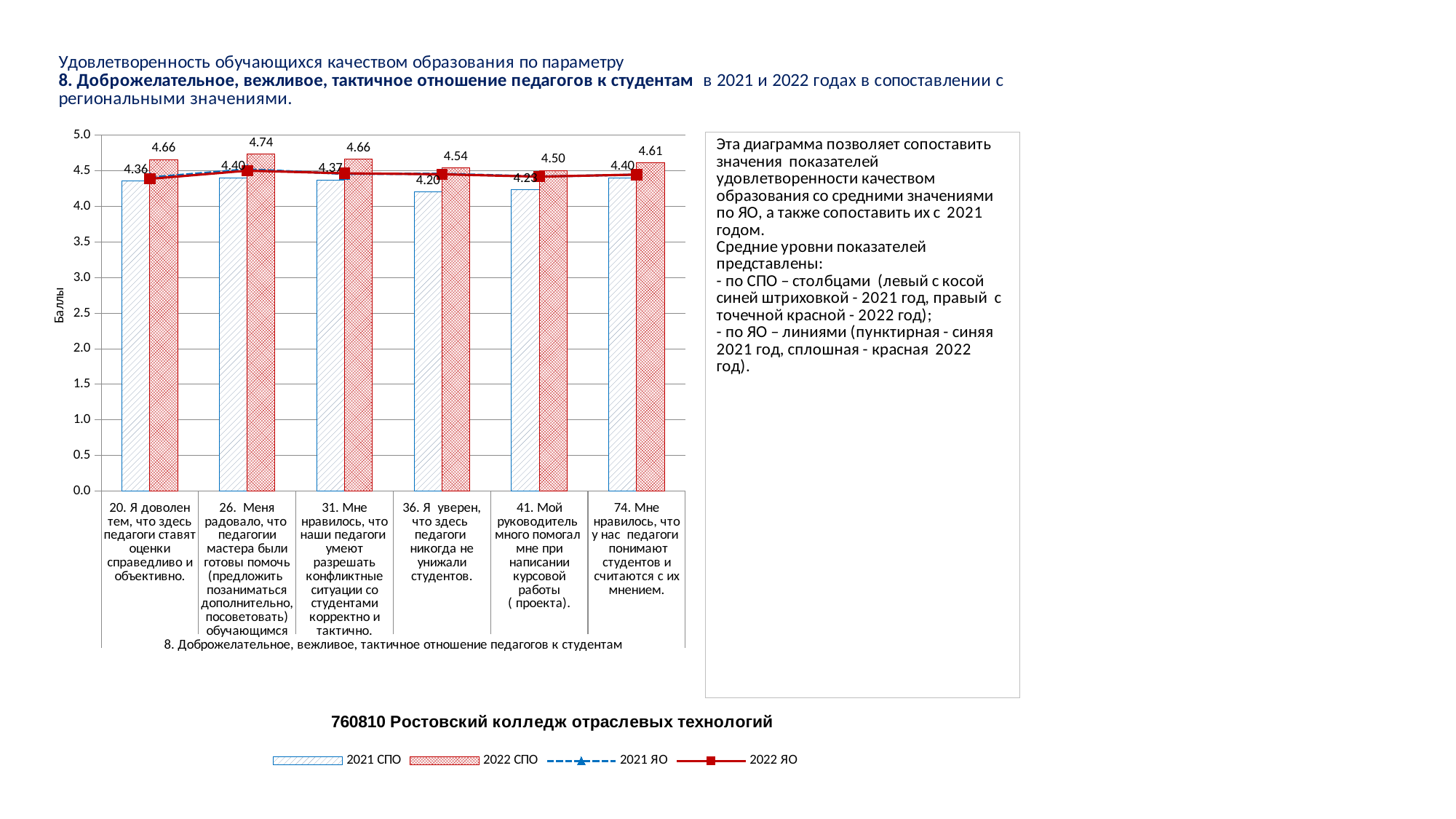
What kind of chart is shown on the slide? Combined bar and line chart Is the 2021 СПО value for category "31. Мне нравилось, что наши педагоги умеют разрешать конфликтные ситуации..." greater or less than 4.5? less Which is larger for category "74. Мне нравилось, что у нас педагоги понимают студентов и считаются с их мнением.": the 2021 СПО value or the 2022 СПО value? 2022 СПО What is the 2021 СПО value for category "41. Мой руководитель много помогал мне при написании курсовой работы (проекта)."? 4.23 How many series does the chart legend list? 4 Which category has the highest 2022 СПО value? 26. Меня радовало, что педагоги мастера были готовы помочь (предложить позаниматься дополнительно, посоветовать) обучающимся Which category has the lowest 2021 СПО value? 36. Я уверен, что здесь педагоги никогда не унижали студентов. How many categories are shown on the x axis of the chart? 6 What is the difference between the 2022 СПО and 2021 СПО values for category "20. Я доволен тем, что здесь педагоги ставят оценки справедливо и объективно."? 0.30 What is the 2022 СПО value for category "36. Я уверен, что здесь педагоги никогда не унижали студентов."? 4.54 What is the 2022 СПО value for category "26. Меня радовало, что педагоги мастера были готовы помочь..."? 4.74 What is the label of the vertical axis of the chart? Баллы